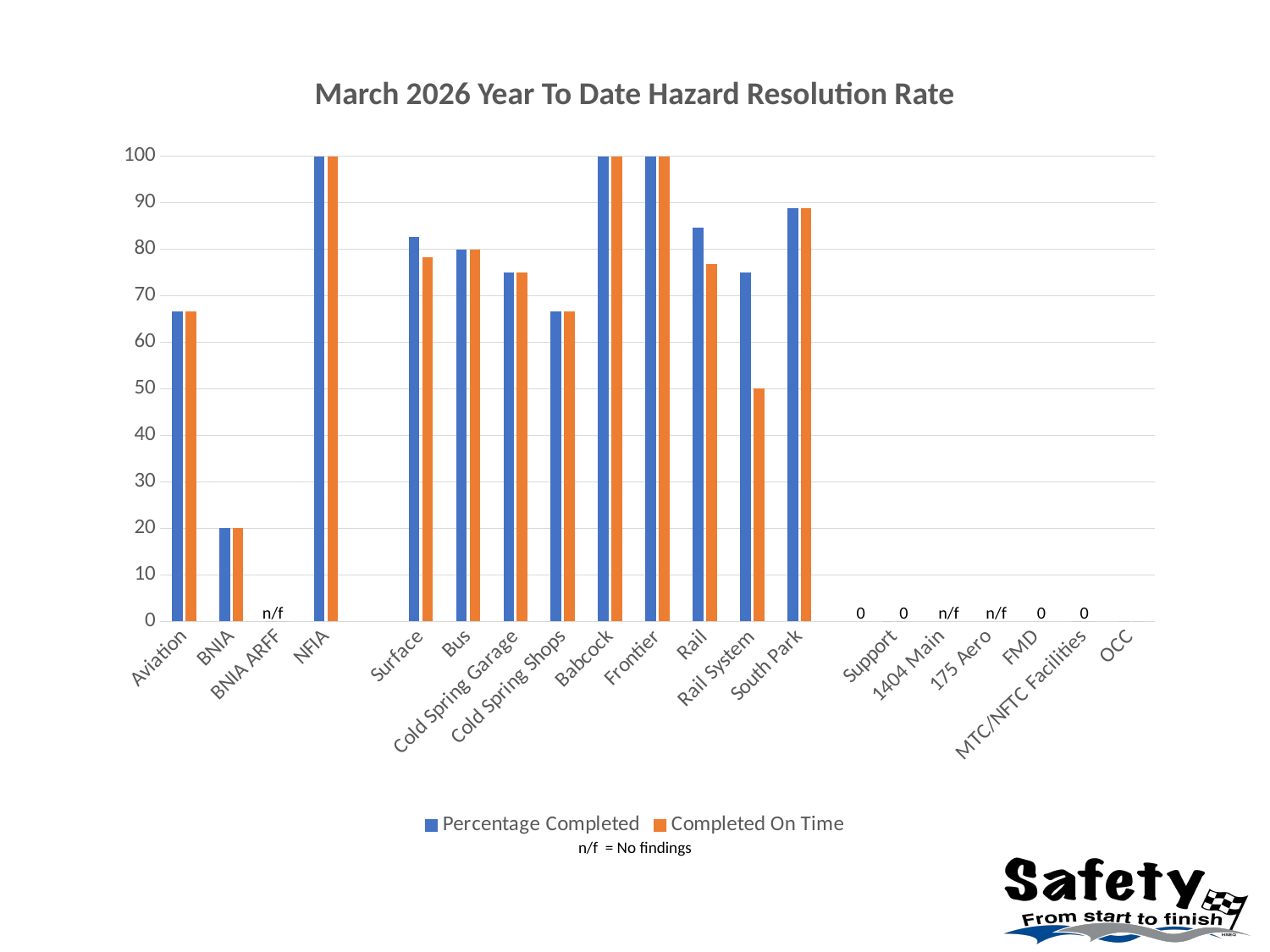
What type of chart is shown on the slide? Bar chart What is the Completed On Time value for Rail System? 50 How many categories are labeled n/f? 3 Is the Completed On Time value for South Park greater or less than 80? greater What value is shown for Support? 0 What is the difference between the Percentage Completed values for NFIA and BNIA? 80 For Rail System, which is larger: Percentage Completed or Completed On Time? Percentage Completed How many series does the legend list? 2 What is the Completed On Time value for BNIA? 20 According to the note below the legend, what does n/f stand for? No findings What is the Percentage Completed value for NFIA? 100 Is the Percentage Completed value for Aviation greater or less than 60? greater